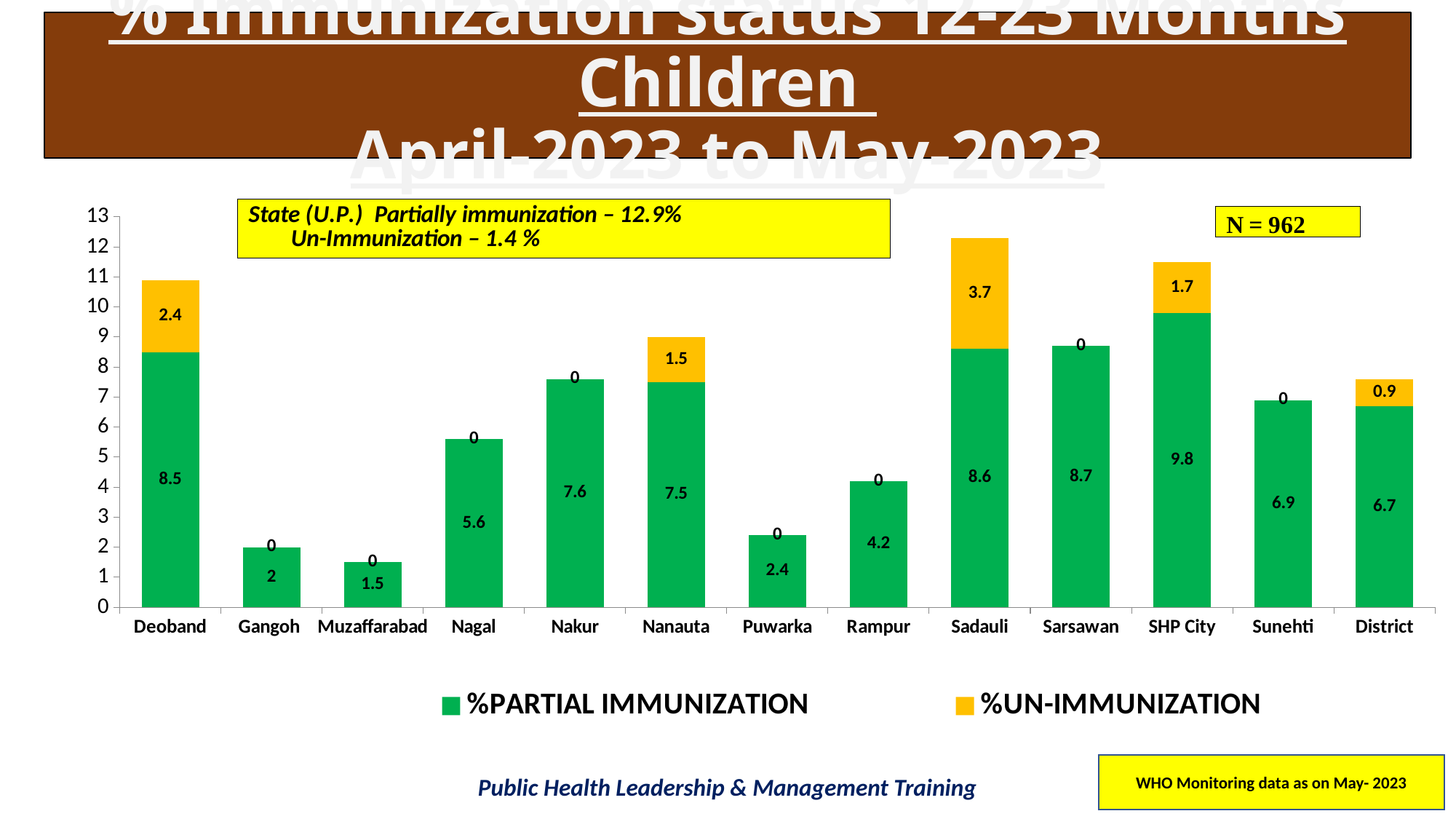
What kind of chart is shown on the slide? Stacked bar chart What is the total of the stacked bar for Sadauli? 12.3 What is the difference between the %PARTIAL IMMUNIZATION values for SHP City and Nagal? 4.2 Which has a larger %PARTIAL IMMUNIZATION value, Rampur or Puwarka? Rampur How many categories are shown on the x axis? 13 What is the %PARTIAL IMMUNIZATION value for Deoband? 8.5 Which category has the highest %UN-IMMUNIZATION value? Sadauli Which category has the lowest %PARTIAL IMMUNIZATION value? Muzaffarabad How many series does the legend list? 2 Which category has the highest %PARTIAL IMMUNIZATION value? SHP City What is the %UN-IMMUNIZATION value for Sadauli? 3.7 What is the %PARTIAL IMMUNIZATION value for District? 6.7